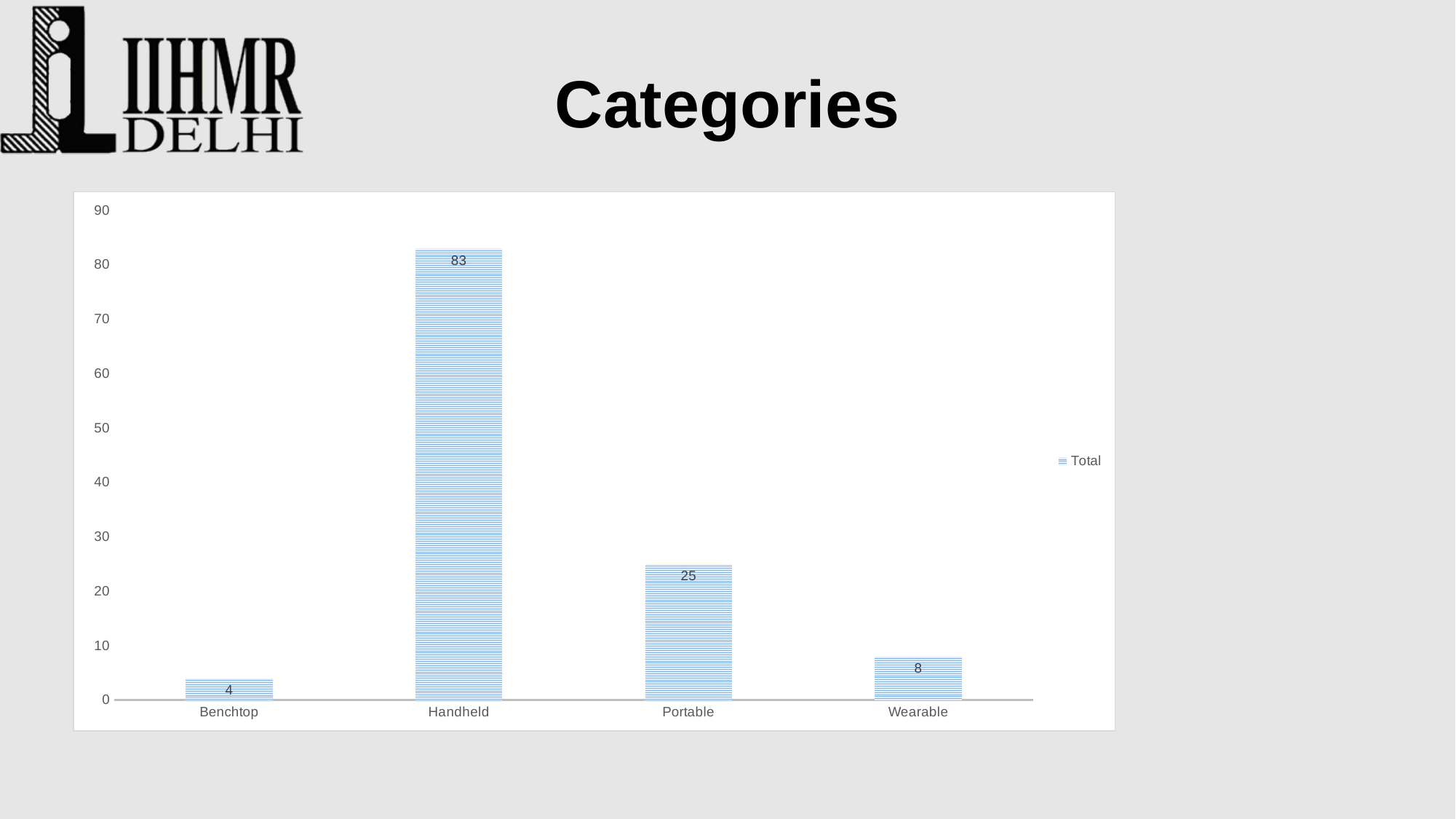
What is the difference between the values for Handheld and Portable? 58 What is the value for Handheld? 83 Which is larger, the value for Portable or the value for Wearable? Portable What is the value for Benchtop? 4 What is the name of the series shown in the legend? Total What kind of chart is shown on the slide? bar chart Is the value for Portable greater or less than 20? greater How many series does the legend list? 1 How many categories are shown on the x axis? 4 Which category has the lowest value? Benchtop Which category has the highest value? Handheld What is the value for Wearable? 8